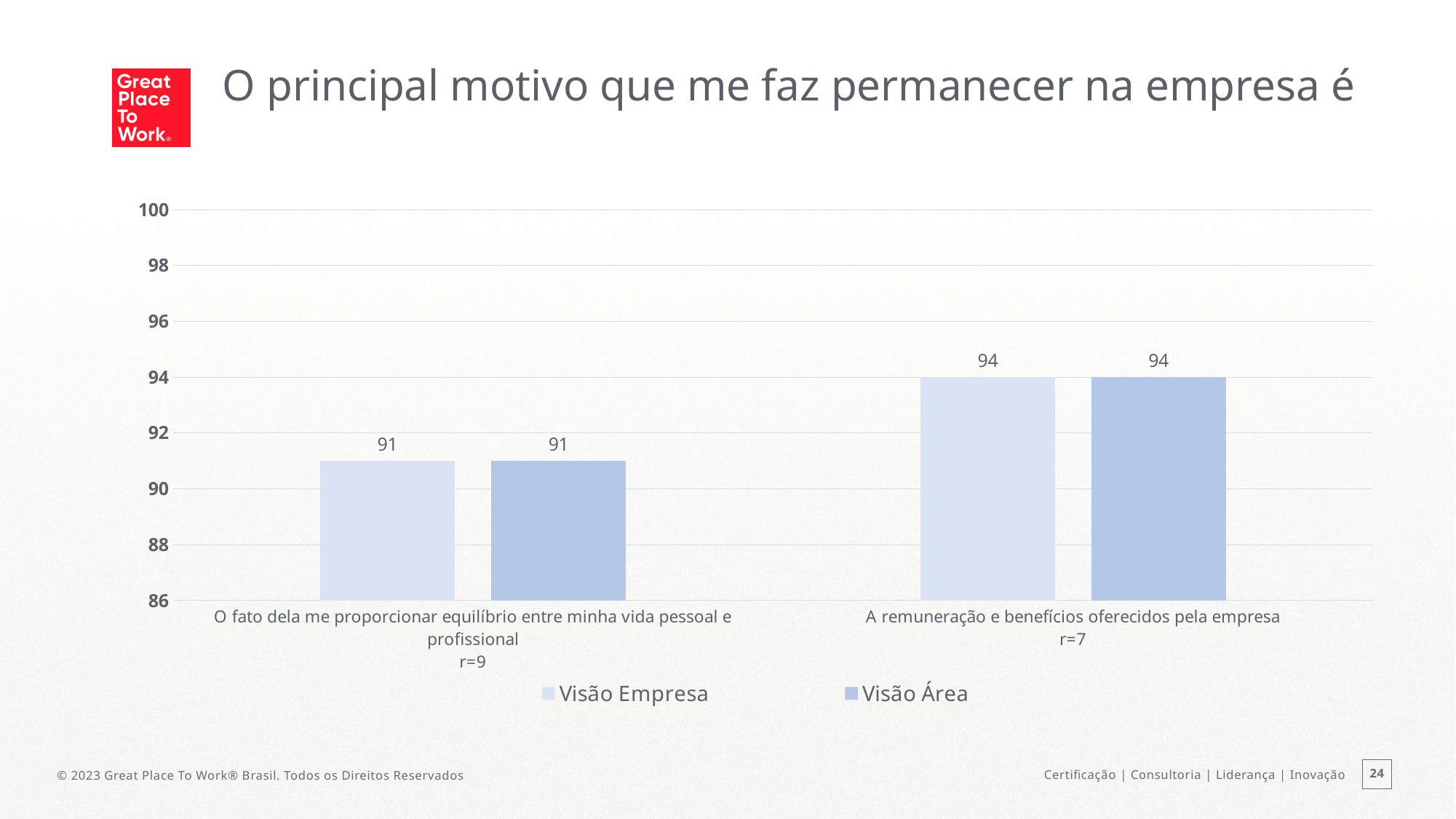
What is the title of the slide? O principal motivo que me faz permanecer na empresa é Is the Visão Empresa value for "A remuneração e benefícios oferecidos pela empresa" greater or less than 92? greater What is the Visão Área value for "O fato dela me proporcionar equilíbrio entre minha vida pessoal e profissional"? 91 Which category has the lowest Visão Empresa value? O fato dela me proporcionar equilíbrio entre minha vida pessoal e profissional How many series does the legend list? 2 What is the Visão Empresa value for "A remuneração e benefícios oferecidos pela empresa"? 94 What is the Visão Empresa value for "O fato dela me proporcionar equilíbrio entre minha vida pessoal e profissional"? 91 Which category has the highest Visão Área value? A remuneração e benefícios oferecidos pela empresa What kind of chart is shown on the slide? bar chart How many categories are shown on the x axis? 2 Which is larger: the Visão Área value for "A remuneração e benefícios oferecidos pela empresa" or for "O fato dela me proporcionar equilíbrio entre minha vida pessoal e profissional"? A remuneração e benefícios oferecidos pela empresa What is the difference between the Visão Empresa values for "A remuneração e benefícios oferecidos pela empresa" and "O fato dela me proporcionar equilíbrio entre minha vida pessoal e profissional"? 3